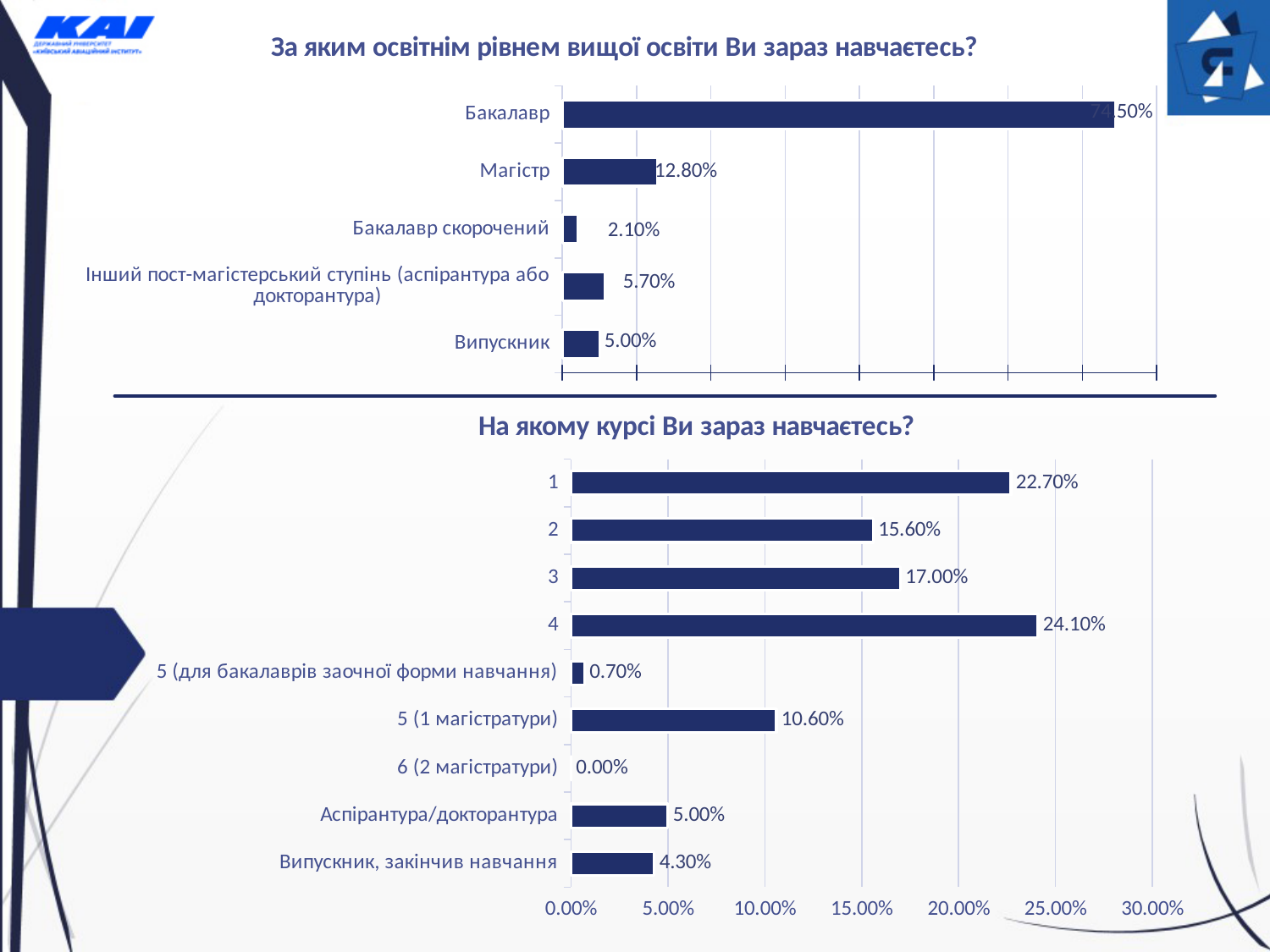
In the top chart 'За яким освітнім рівнем вищої освіти Ви зараз навчаєтесь?', what is the value for Бакалавр скорочений? 2.10% In the top chart 'За яким освітнім рівнем вищої освіти Ви зараз навчаєтесь?', what is the difference between the values for Магістр and Випускник? 7.80% In the top chart 'За яким освітнім рівнем вищої освіти Ви зараз навчаєтесь?', which category has the highest value? Бакалавр In the top chart 'За яким освітнім рівнем вищої освіти Ви зараз навчаєтесь?', which category has the lowest value? Бакалавр скорочений In the top chart 'За яким освітнім рівнем вищої освіти Ви зараз навчаєтесь?', how many categories are shown? 5 In the bottom chart 'На якому курсі Ви зараз навчаєтесь?', what is the value for course 4? 24.10% What type of chart is the bottom chart 'На якому курсі Ви зараз навчаєтесь?'? Bar chart In the bottom chart 'На якому курсі Ви зараз навчаєтесь?', which is larger, the value for course 2 or course 3? 3 In the top chart 'За яким освітнім рівнем вищої освіти Ви зараз навчаєтесь?', what is the value for Магістр? 12.80% In the bottom chart 'На якому курсі Ви зараз навчаєтесь?', what is the difference between the values for course 1 and course 2? 7.10% In the bottom chart 'На якому курсі Ви зараз навчаєтесь?', what is the value for 5 (1 магістратури)? 10.60% In the bottom chart 'На якому курсі Ви зараз навчаєтесь?', which category has the highest value? 4